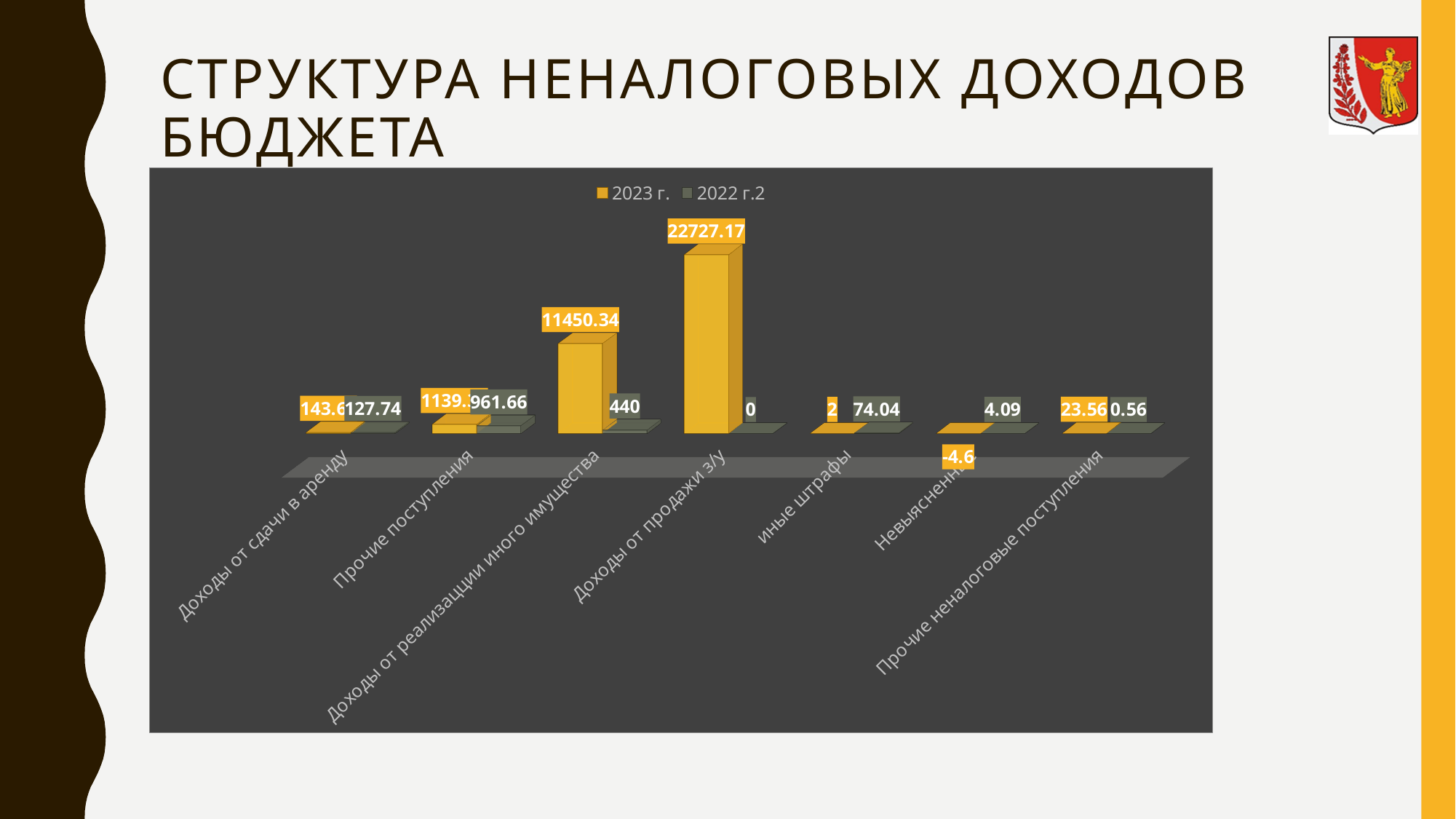
How many series does the legend list? 2 What is the 2022 г.2 value for иные штрафы? 74.04 What is the 2023 г. value for Прочие неналоговые поступления? 23.56 What kind of chart is shown on the slide? bar chart Which category has the highest 2023 г. value? Доходы от продажи з/у What is the 2023 г. value for Доходы от продажи з/у? 22727.17 Which series are listed in the legend? 2023 г. and 2022 г.2 What is the difference between the 2023 г. values for Доходы от продажи з/у and Доходы от реализации иного имущества? 11276.83 What is the 2022 г.2 value for Доходы от продажи з/у? 0 What is the 2023 г. value for Доходы от реализации иного имущества? 11450.34 What is the 2022 г.2 value for Доходы от реализации иного имущества? 440 How many categories are shown on the x axis? 7